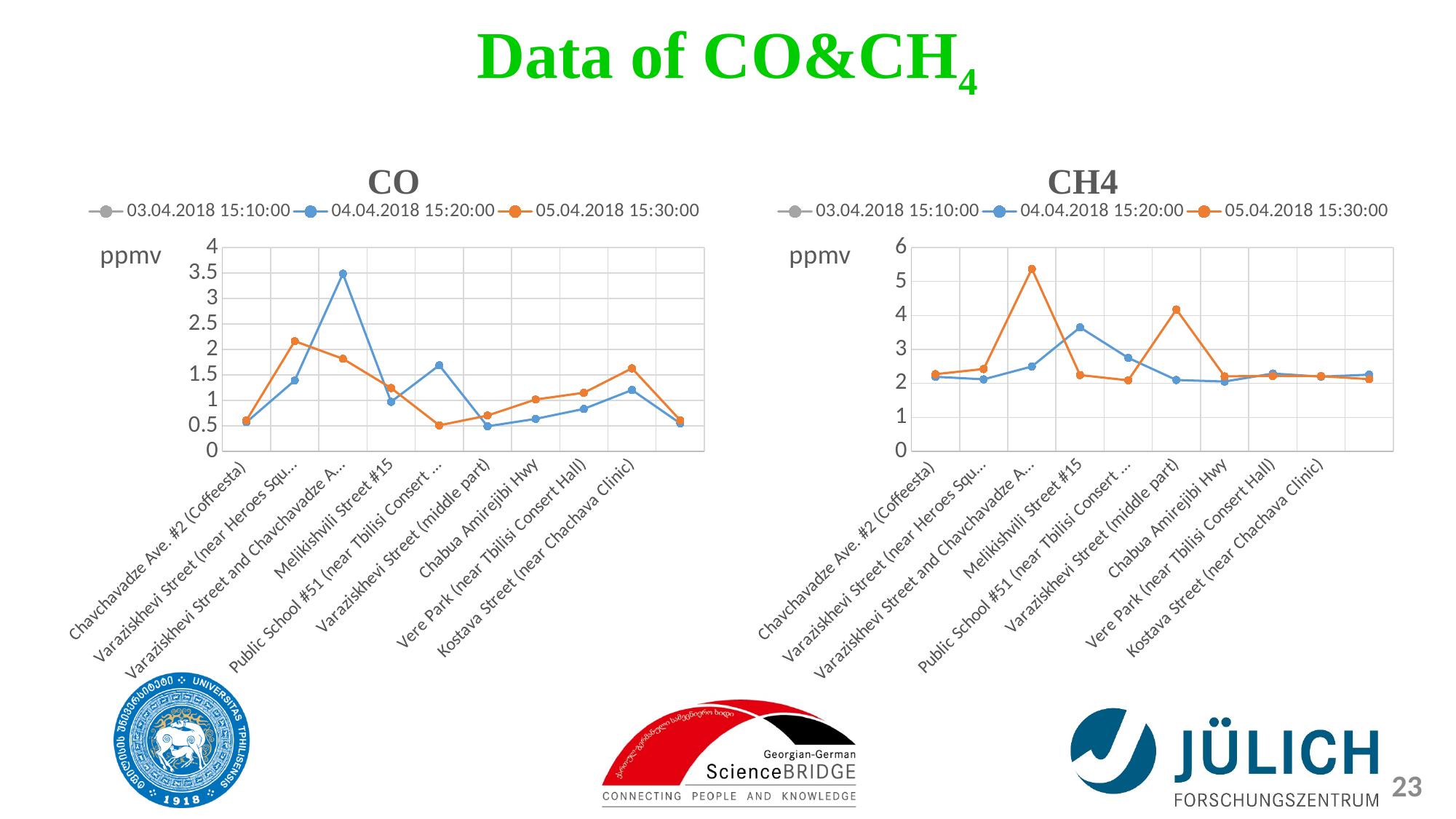
What kind of chart is the CO chart? line chart What unit is shown on the y axis of the CH4 chart? ppmv How many series does the legend of the CH4 chart list? 3 In the CH4 chart, at which location does the 05.04.2018 15:30:00 series reach its highest value? Varaziskhevi Street and Chavchavadze A... In the CO chart, is the 05.04.2018 15:30:00 value at Public School #51 greater or less than 1? less In the CH4 chart, which series has the larger value at Melikishvili Street #15, 04.04.2018 15:20:00 or 05.04.2018 15:30:00? 04.04.2018 15:20:00 In the CH4 chart, is the 04.04.2018 15:20:00 value at Melikishvili Street #15 greater or less than 3? greater In the CO chart, is the 04.04.2018 15:20:00 value at Public School #51 greater or less than 1.5? greater In the CO chart, at which location does the 04.04.2018 15:20:00 series reach its highest value? Varaziskhevi Street and Chavchavadze A... How many locations are shown on the x axis of the CO chart? 9 In the CO chart, which series has the larger value at Varaziskhevi Street and Chavchavadze A..., 04.04.2018 15:20:00 or 05.04.2018 15:30:00? 04.04.2018 15:20:00